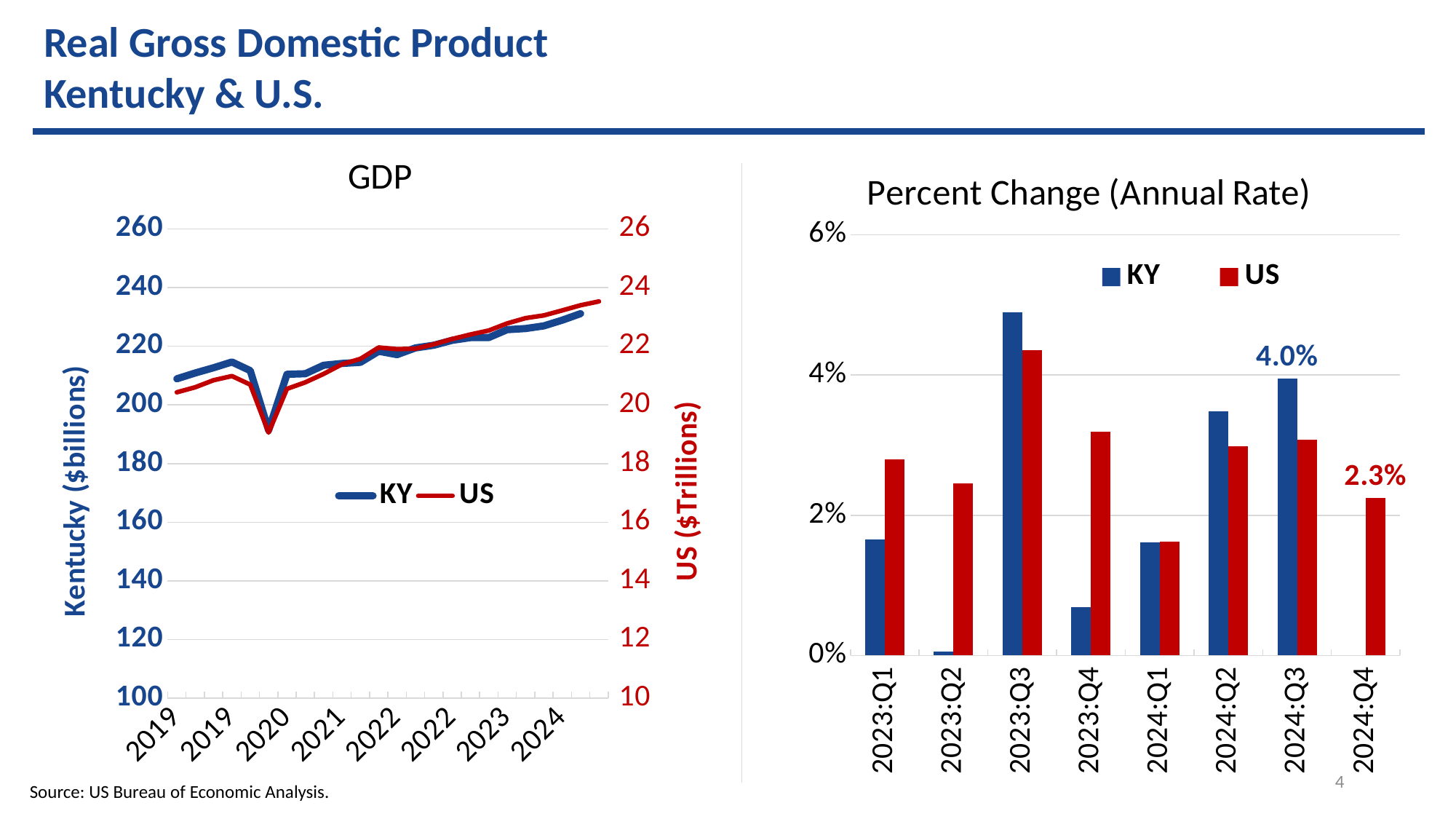
What is the label of the right-hand vertical axis on the GDP chart? US ($Trillions) How many series does the legend of the Percent Change (Annual Rate) chart list? 2 How many quarters are shown on the x axis of the Percent Change (Annual Rate) chart? 8 On the Percent Change (Annual Rate) chart, in which quarter is the KY bar lowest? 2023:Q2 On the Percent Change (Annual Rate) chart, what is the value for US in 2024:Q4? 2.3% On the Percent Change (Annual Rate) chart, what is the value for KY in 2024:Q3? 4.0% On the Percent Change (Annual Rate) chart, in which quarter is the KY bar highest? 2023:Q3 On the GDP chart, do the KY and US lines generally rise or fall from 2019 to 2024? rise On the Percent Change (Annual Rate) chart, in 2023:Q4, which is larger, KY or US? US On the Percent Change (Annual Rate) chart, is the value for KY in 2023:Q3 greater or less than 4%? greater On the Percent Change (Annual Rate) chart, is the value for KY in 2023:Q4 greater or less than 2%? less What kind of chart is the GDP chart on the left? line chart